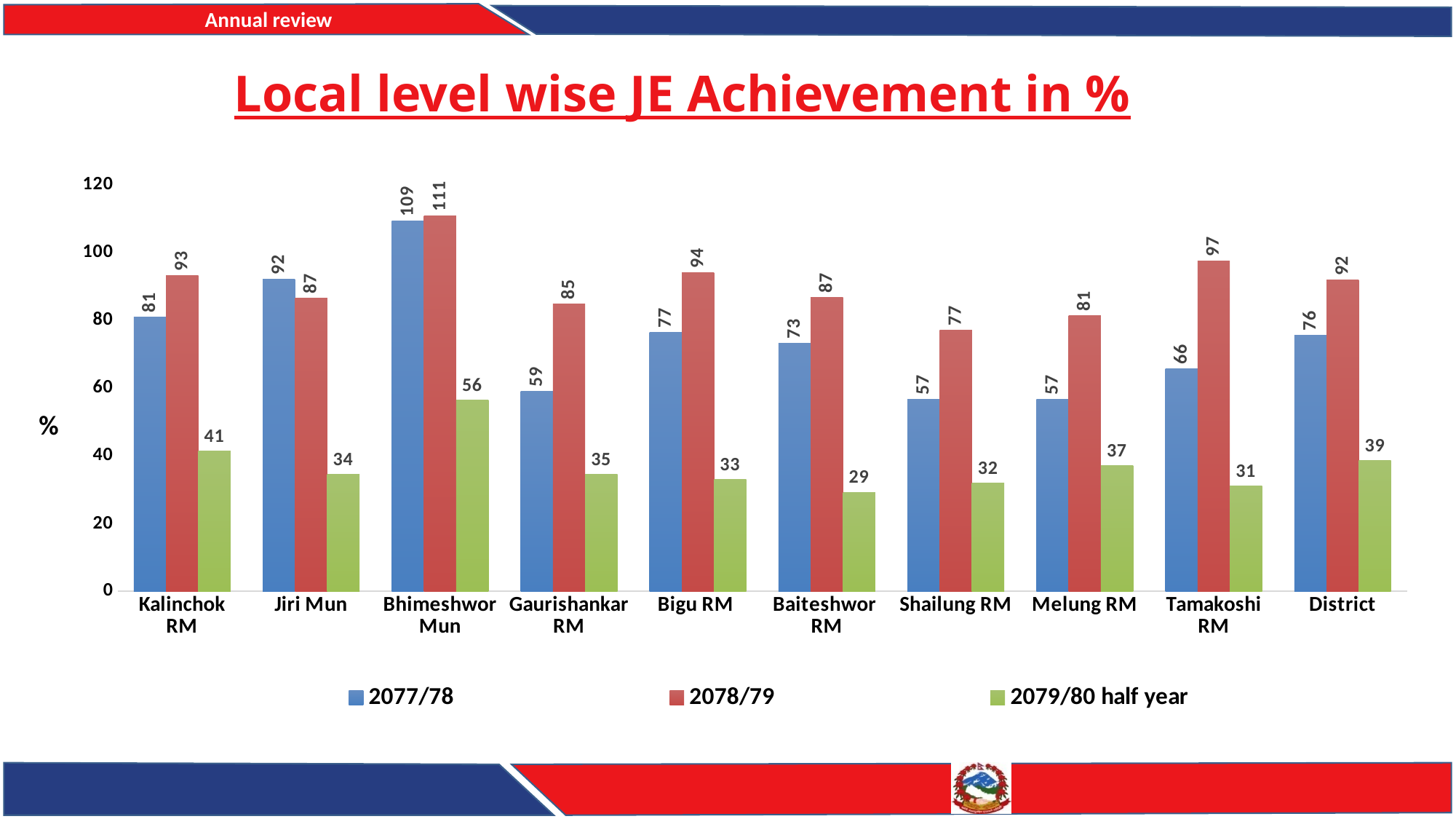
What is the 2077/78 value for District? 76 Which is larger for Jiri Mun: the 2077/78 value or the 2078/79 value? 2077/78 What is the title of the chart? Local level wise JE Achievement in % Which local level has the lowest 2079/80 half year value? Baiteshwor RM What kind of chart is shown on the slide? Bar chart Which local level has the highest 2078/79 value? Bhimeshwor Mun Is the 2077/78 value for Bhimeshwor Mun greater or less than 100? greater What is the 2079/80 half year value for Bhimeshwor Mun? 56 How many local level categories are shown on the x axis? 10 What is the difference between the 2078/79 and 2077/78 values for Tamakoshi RM? 31 How many series does the legend list? 3 What is the 2078/79 value for Bigu RM? 94